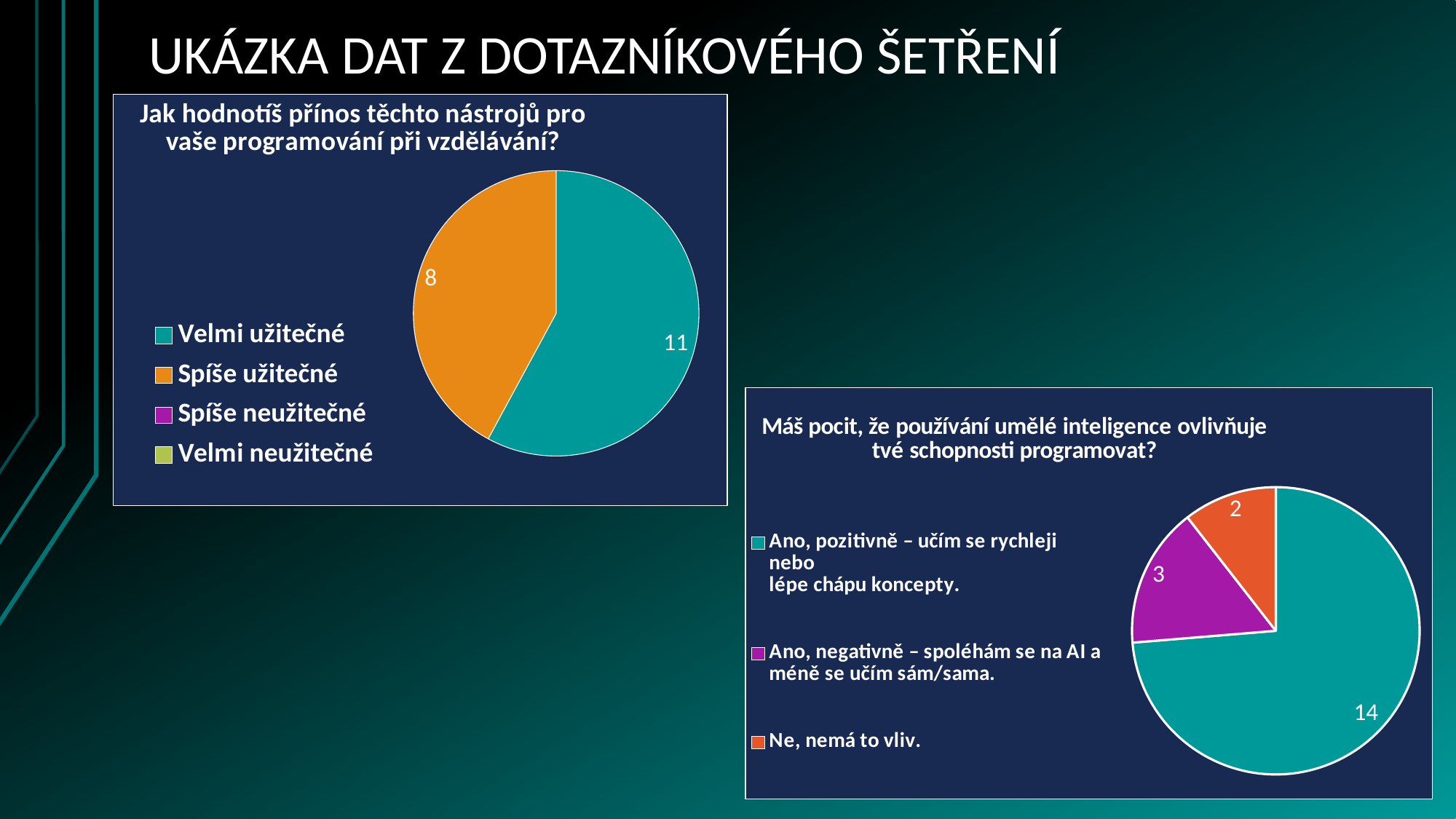
In the left chart ("Jak hodnotíš přínos těchto nástrojů pro vaše programování při vzdělávání?"), what is the difference between "Velmi užitečné" and "Spíše užitečné"? 3 In the left chart ("Jak hodnotíš přínos těchto nástrojů pro vaše programování při vzdělávání?"), which category has the largest slice? Velmi užitečné In the left chart ("Jak hodnotíš přínos těchto nástrojů pro vaše programování při vzdělávání?"), what is the value for "Velmi užitečné"? 11 In the right chart ("Máš pocit, že používání umělé inteligence ovlivňuje tvé schopnosti programovat?"), what is the value for "Ano, negativně – spoléhám se na AI a méně se učím sám/sama."? 3 In the right chart ("Máš pocit, že používání umělé inteligence ovlivňuje tvé schopnosti programovat?"), what is the value for "Ne, nemá to vliv."? 2 In the left chart ("Jak hodnotíš přínos těchto nástrojů pro vaše programování při vzdělávání?"), what is the value for "Spíše užitečné"? 8 In the right chart ("Máš pocit, že používání umělé inteligence ovlivňuje tvé schopnosti programovat?"), which category has the smallest slice? Ne, nemá to vliv. What type of chart is the left chart ("Jak hodnotíš přínos těchto nástrojů pro vaše programování při vzdělávání?")? Pie chart In the left chart ("Jak hodnotíš přínos těchto nástrojů pro vaše programování při vzdělávání?"), how many entries does the legend list? 4 In the right chart ("Máš pocit, že používání umělé inteligence ovlivňuje tvé schopnosti programovat?"), what colour is the slice for "Ne, nemá to vliv."? Orange In the right chart ("Máš pocit, že používání umělé inteligence ovlivňuje tvé schopnosti programovat?"), how many slices does the pie have? 3 In the right chart ("Máš pocit, že používání umělé inteligence ovlivňuje tvé schopnosti programovat?"), what is the value for "Ano, pozitivně – učím se rychleji nebo lépe chápu koncepty."? 14